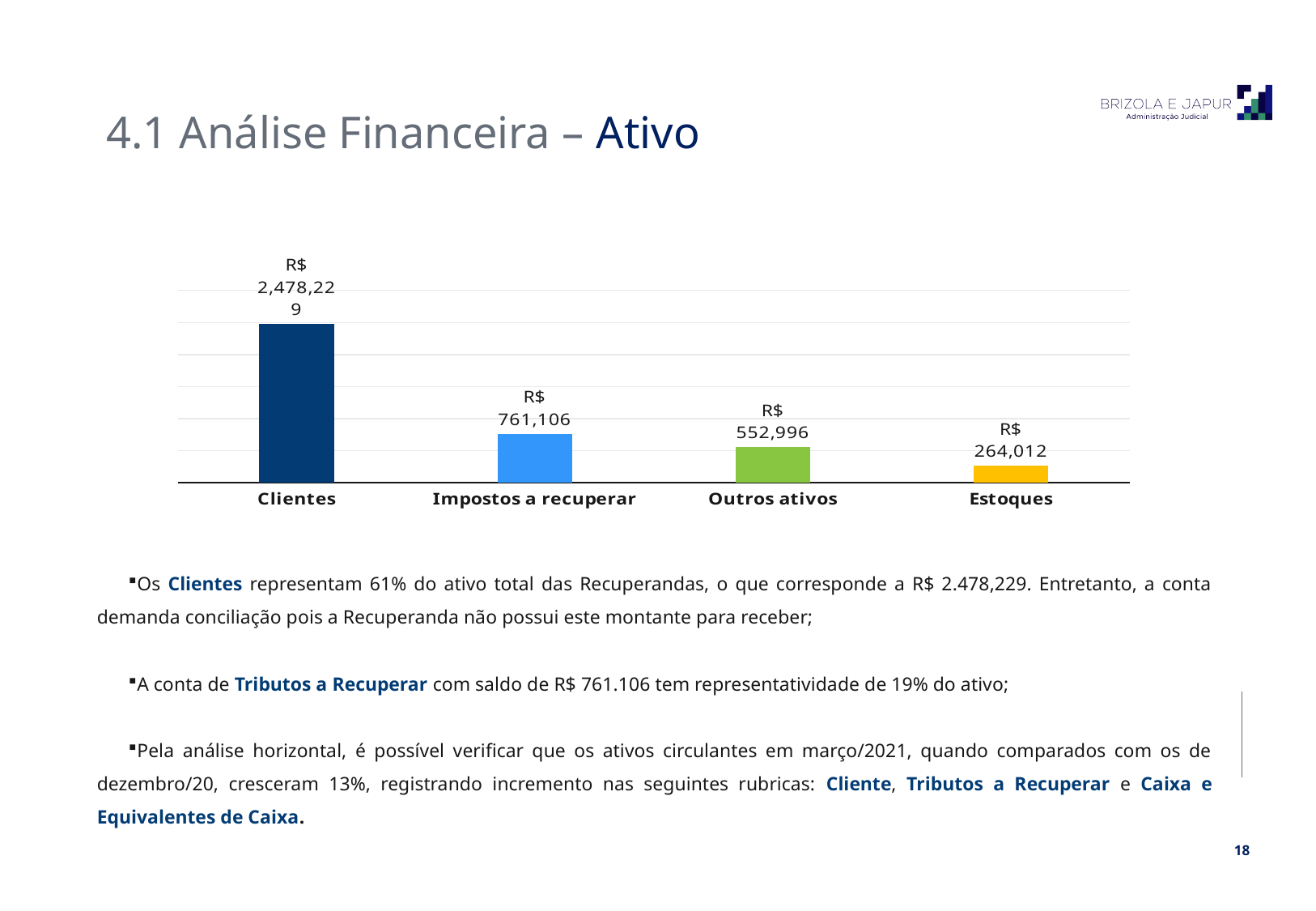
What kind of chart is shown on the slide? Bar chart What is the value for Clientes? R$ 2,478,229 What is the difference between the values for Clientes and Impostos a recuperar? R$ 1,717,123 What is the value for Outros ativos? R$ 552,996 Do the values rise or fall from left to right across the categories? Fall What is the value for Estoques? R$ 264,012 How many categories are shown in the chart? 4 Which category has the lowest value? Estoques Which is larger, the value for Impostos a recuperar or the value for Outros ativos? Impostos a recuperar What is the difference between the values for Outros ativos and Estoques? R$ 288,984 Which category has the highest value? Clientes What is the value for Impostos a recuperar? R$ 761,106